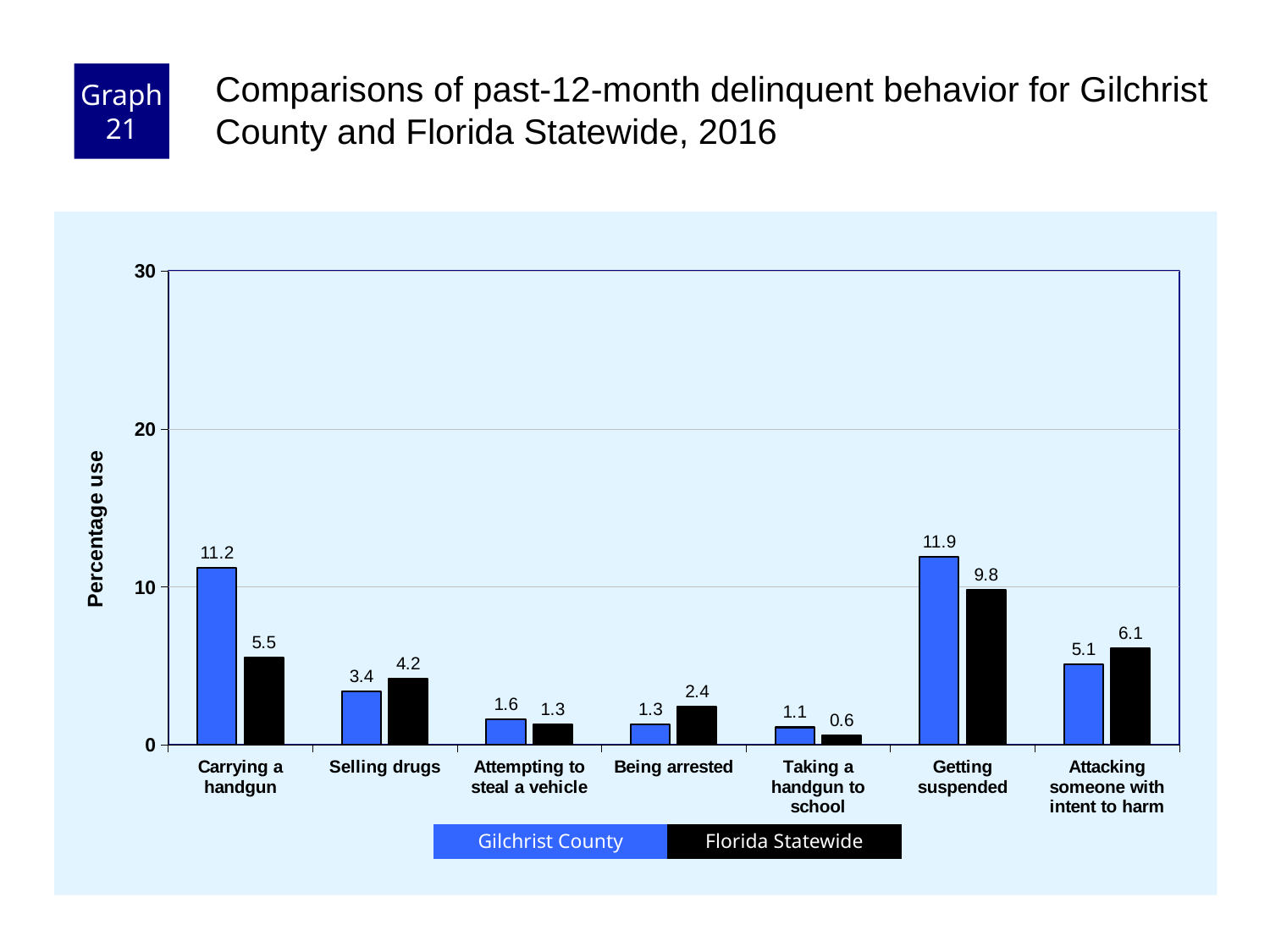
What is the Gilchrist County value for Carrying a handgun? 11.2 What is the label of the y axis? Percentage use What is the Florida Statewide value for Taking a handgun to school? 0.6 How many series does the legend list? 2 Which category has the highest Gilchrist County value? Getting suspended Is the Gilchrist County value for Getting suspended greater or less than 10? greater Which category has the lowest Florida Statewide value? Taking a handgun to school What kind of chart is shown on the slide? bar chart How many categories are shown on the x axis? 7 What is the Florida Statewide value for Getting suspended? 9.8 For Being arrested, which is larger: Gilchrist County or Florida Statewide? Florida Statewide What is the difference between the Gilchrist County and Florida Statewide values for Carrying a handgun? 5.7